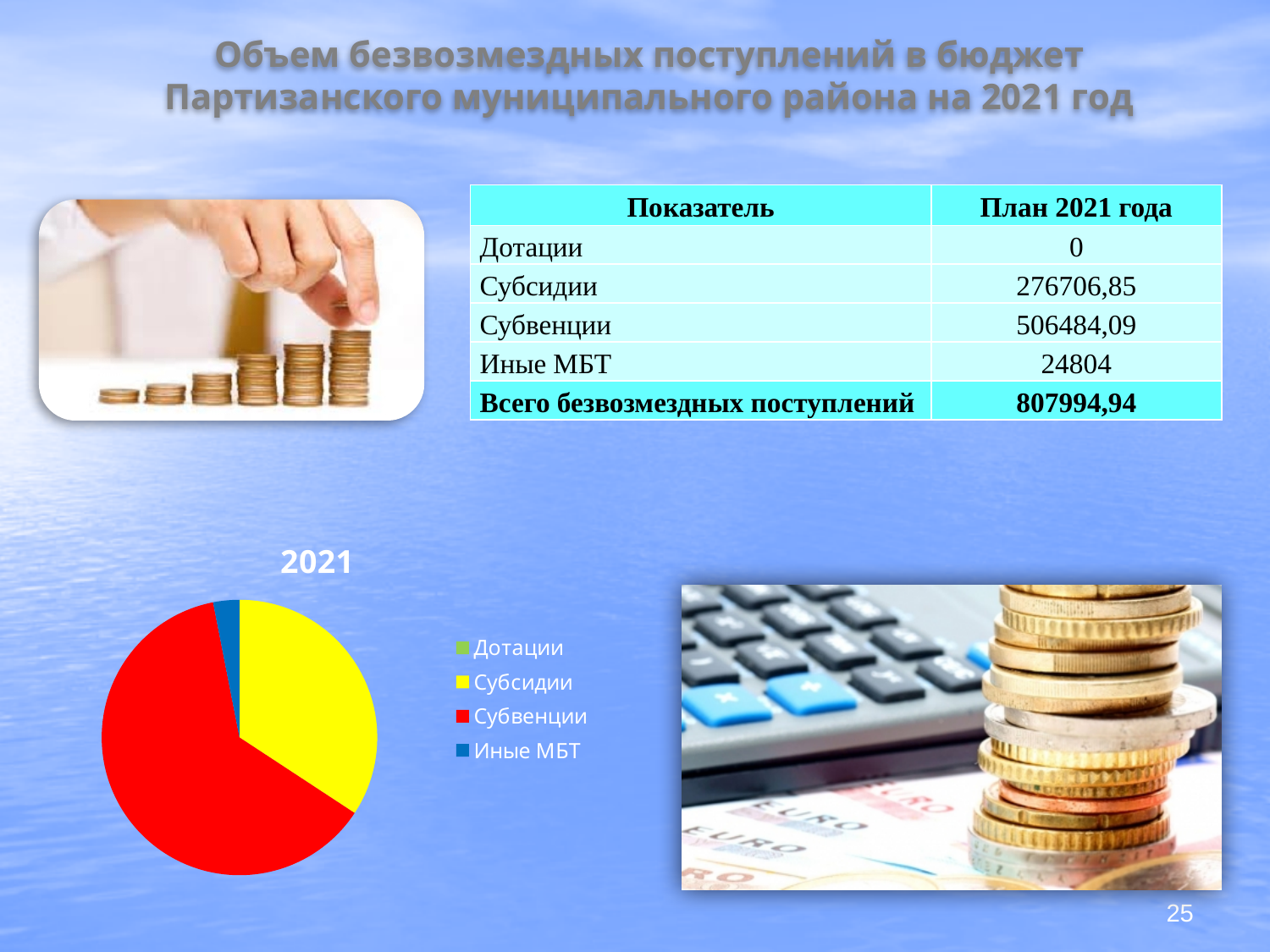
According to the table on the slide, what is the planned 2021 value for Субсидии? 276706,85 According to the table on the slide, what is the planned 2021 value for Иные МБТ? 24804 Which colour represents Субвенции in the pie chart? red Which category has the largest slice in the pie chart? Субвенции Which is larger in the pie chart, Субвенции or Субсидии? Субвенции According to the table on the slide, what is the total of all безвозмездные поступления for 2021? 807994,94 According to the table on the slide, what is the planned 2021 value for Дотации? 0 According to the table on the slide, what is the planned 2021 value for Субвенции? 506484,09 How many categories does the pie chart's legend list? 4 Which is larger in the pie chart, Субсидии or Иные МБТ? Субсидии What is the title of the pie chart? 2021 What kind of chart is shown on the slide? pie chart